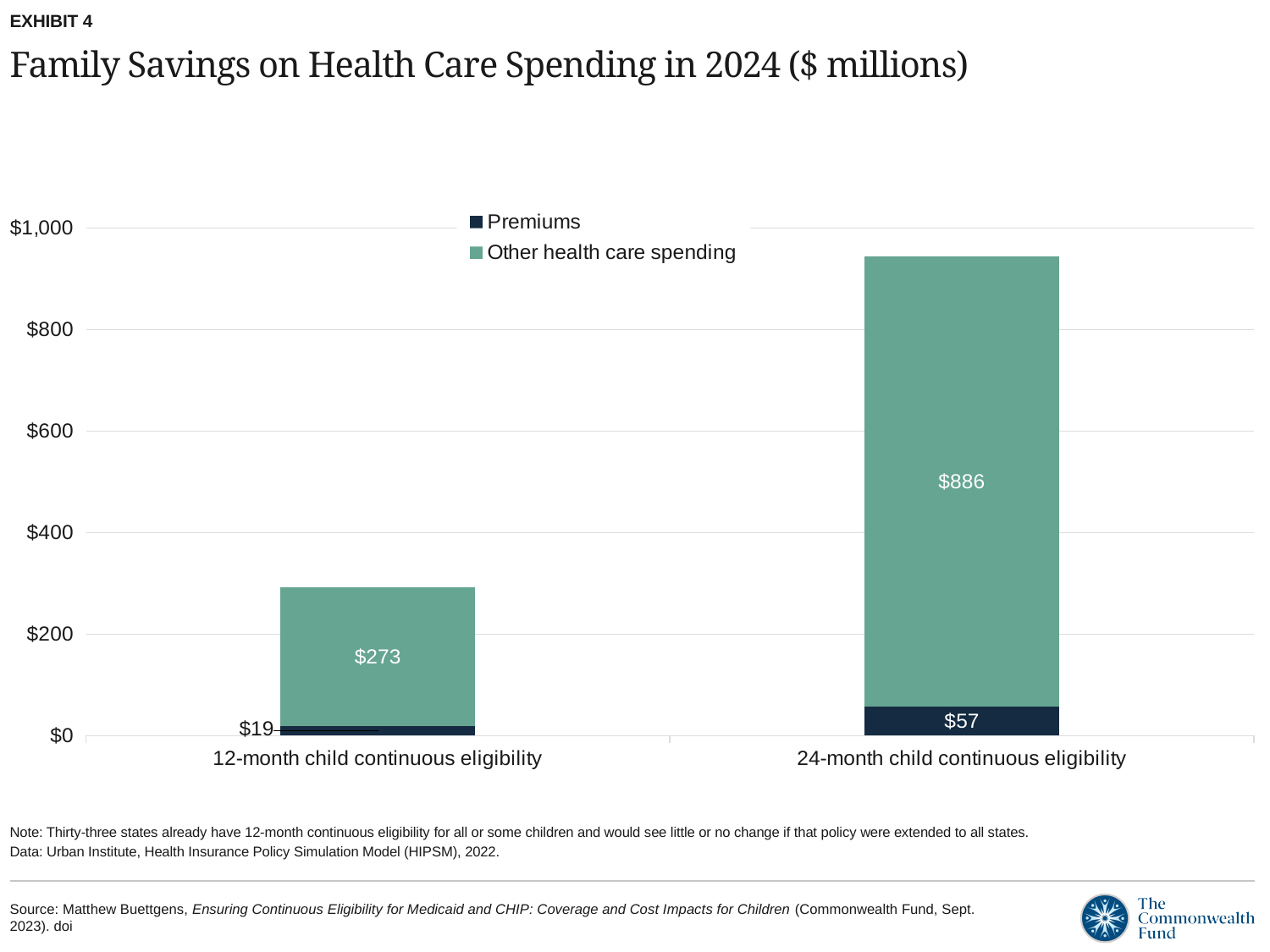
Is the total for 24-month child continuous eligibility greater or less than $800? greater What is the total of the stacked bar for 24-month child continuous eligibility? $943 What is the title of the chart? Family Savings on Health Care Spending in 2024 ($ millions) What is the total of the stacked bar for 12-month child continuous eligibility? $292 What is the value of Premiums for 24-month child continuous eligibility? $57 What is the value of Other health care spending for 12-month child continuous eligibility? $273 What kind of chart is shown? Stacked bar chart How many series does the legend list? 2 Which category has the higher Other health care spending value? 24-month child continuous eligibility What is the value of Premiums for 12-month child continuous eligibility? $19 What is the value of Other health care spending for 24-month child continuous eligibility? $886 What is the difference in Premiums between 24-month and 12-month child continuous eligibility? $38